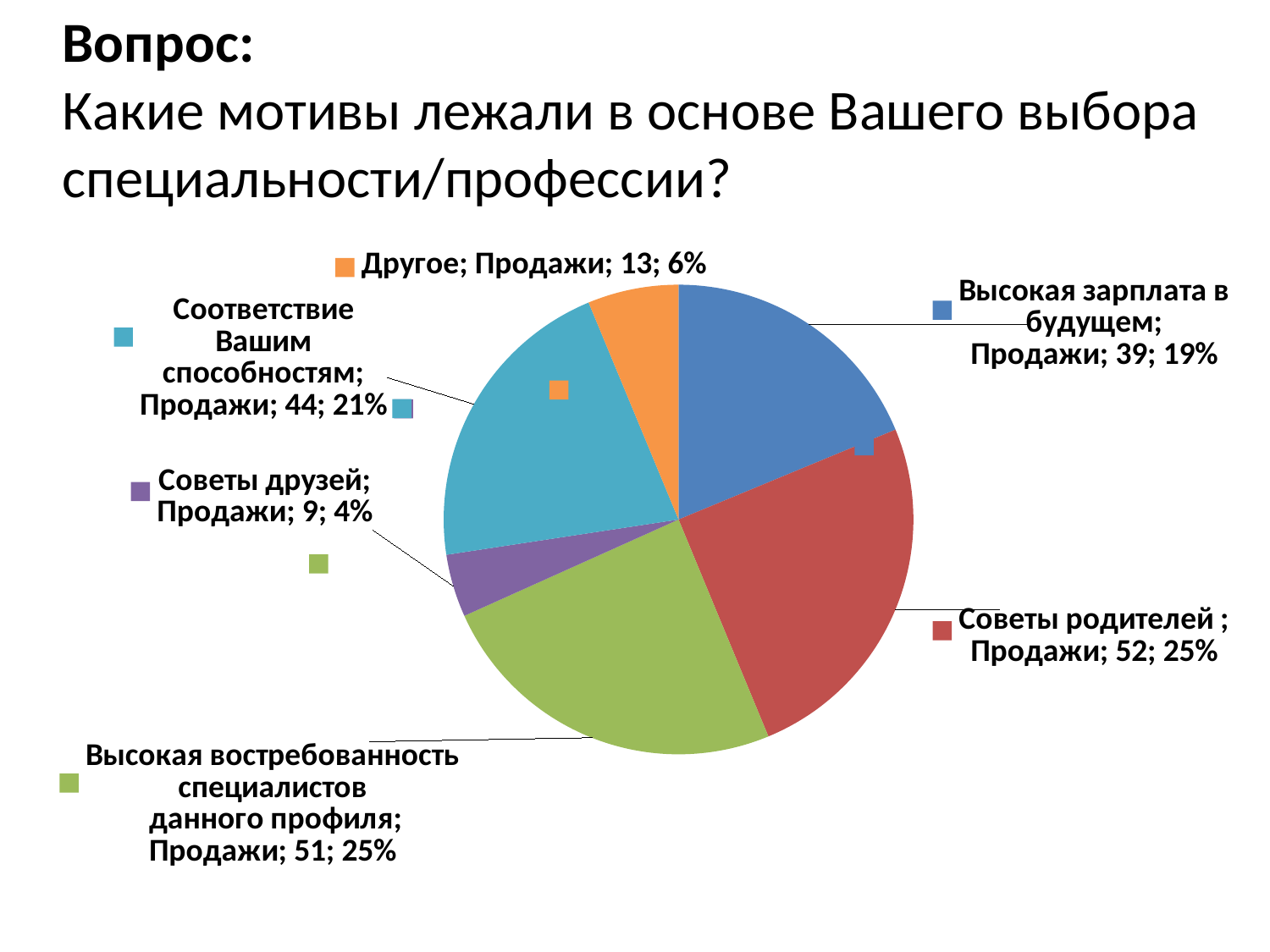
What is the value for "Высокая зарплата в будущем"? 39 What percentage share does "Соответствие Вашим способностям" have? 21% What is the value for "Советы друзей"? 9 What is the difference between the values for "Соответствие Вашим способностям" and "Другое"? 31 Which category has the largest value according to the data labels? Советы родителей Which is larger, the value for "Высокая зарплата в будущем" or the value for "Соответствие Вашим способностям"? Соответствие Вашим способностям What kind of chart is shown on the slide? pie chart What percentage share does "Другое" have? 6% What is the value for "Советы родителей"? 52 How many slices does the pie chart have? 6 Which category has the smallest slice? Советы друзей What series name appears in the data labels of the pie chart? Продажи